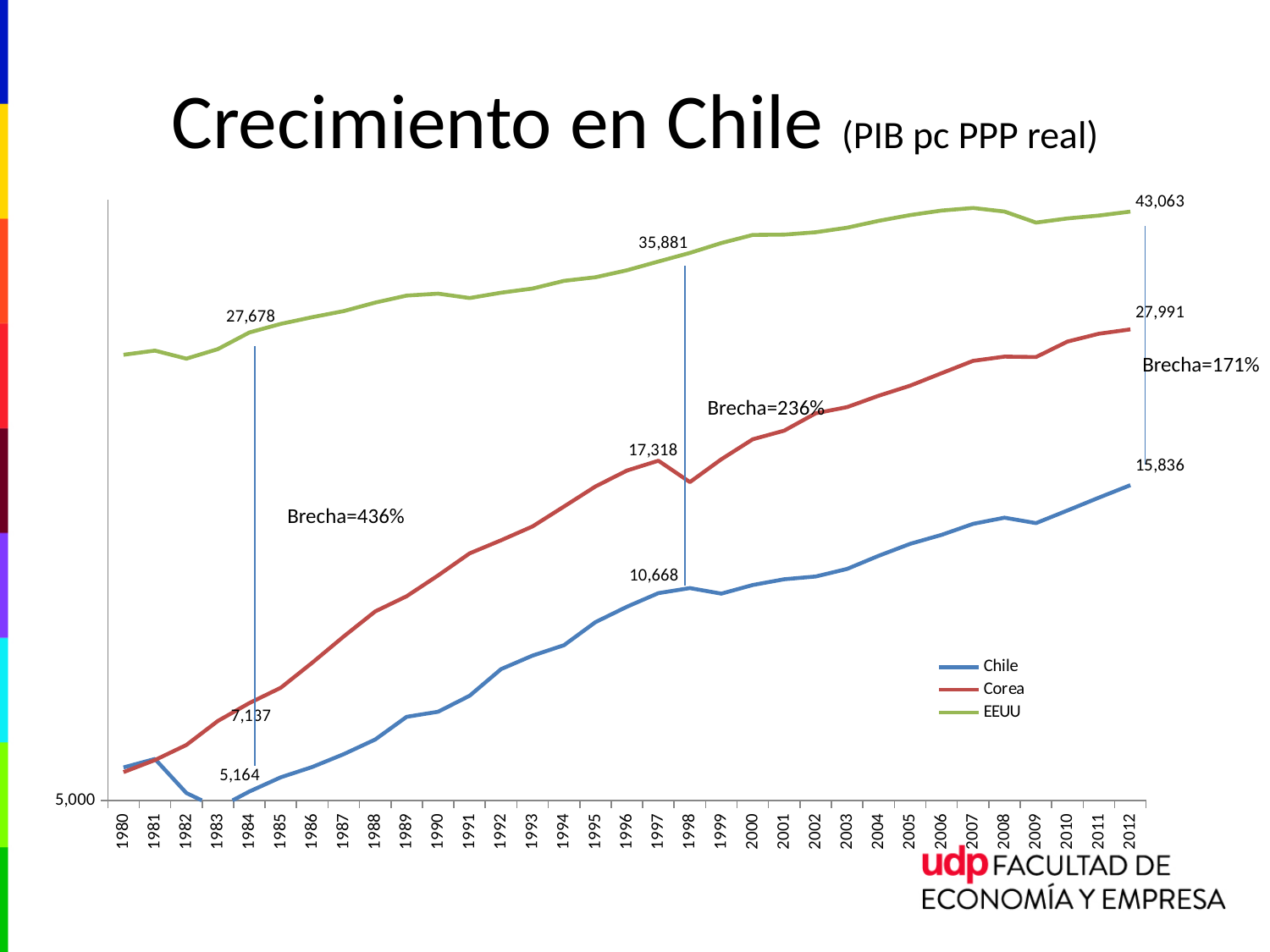
What is the value labelled for EEUU in 2012? 43,063 What is the value labelled for Chile in 2012? 15,836 Which series has the lowest value in 1998? Chile What is the 'Brecha' percentage annotated for 1984? 436% How many series does the legend list? 3 What type of chart is shown on the slide? line chart Which series has the highest value in 2012? EEUU What is the value labelled for Chile in 1984? 5,164 What is the difference between the labelled EEUU and Chile values in 2012? 27,227 Does the Chile series generally rise or fall from 1980 to 2012? rise